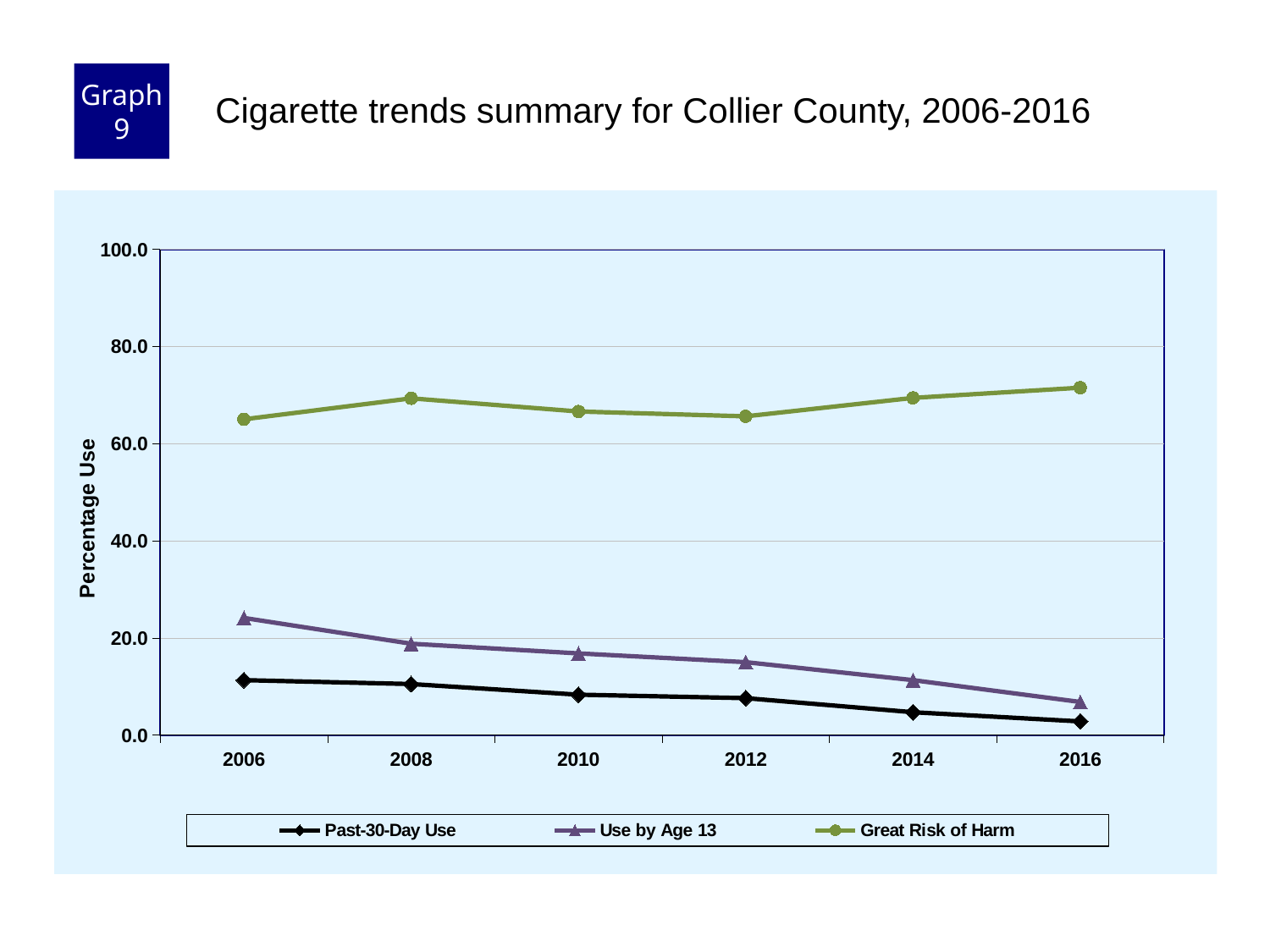
How many years are plotted along the x axis? 6 What is the label on the y axis? Percentage Use Is the Great Risk of Harm value for 2006 greater or less than 60.0? greater In which year is the Use by Age 13 value highest? 2006 Does the Past-30-Day Use series rise or fall from 2006 to 2016? fall What kind of chart is shown on the slide? line chart In 2006, which is larger: Past-30-Day Use or Use by Age 13? Use by Age 13 How many series does the legend list? 3 Does the Use by Age 13 series rise or fall from 2006 to 2016? fall Is the Use by Age 13 value for 2008 greater or less than 20.0? less In which year is the Past-30-Day Use value lowest? 2016 In which year is the Great Risk of Harm value highest? 2016